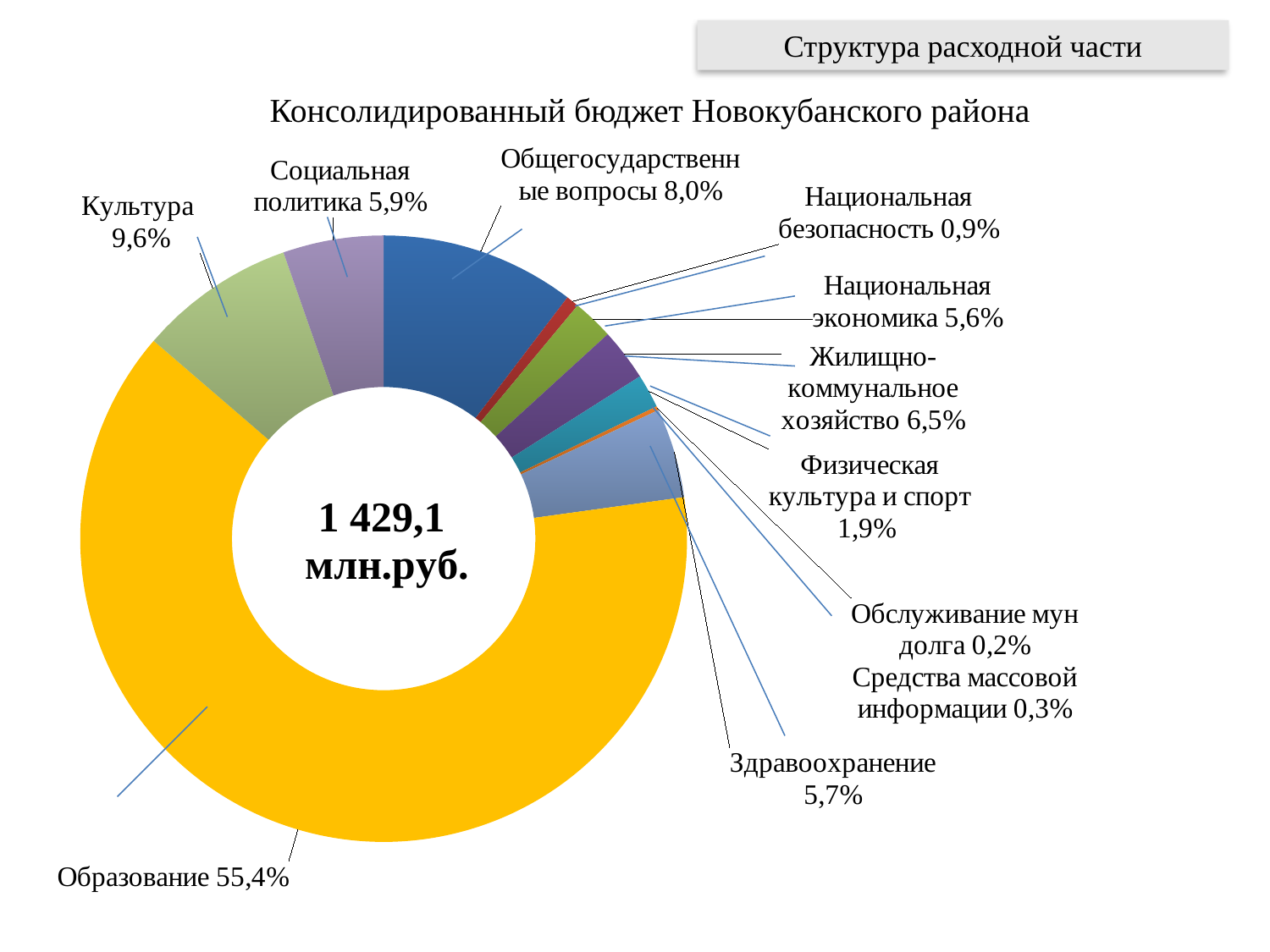
What total amount is shown in the centre of the chart? 1 429,1 млн.руб. What share of the budget goes to Культура? 9,6% Which category has the largest share of the budget? Образование What share of the budget goes to Здравоохранение? 5,7% What is the title of the chart? Консолидированный бюджет Новокубанского района What share of the budget goes to Жилищно-коммунальное хозяйство? 6,5% What kind of chart is shown on the slide? Doughnut (pie) chart Which category has the smallest share of the budget? Обслуживание мун долга How many categories are shown in the chart? 11 What share of the budget goes to Образование? 55,4% What is the difference between the shares for Культура and Национальная экономика? 4,0% Which is larger: the share for Общегосударственные вопросы or the share for Социальная политика? Общегосударственные вопросы